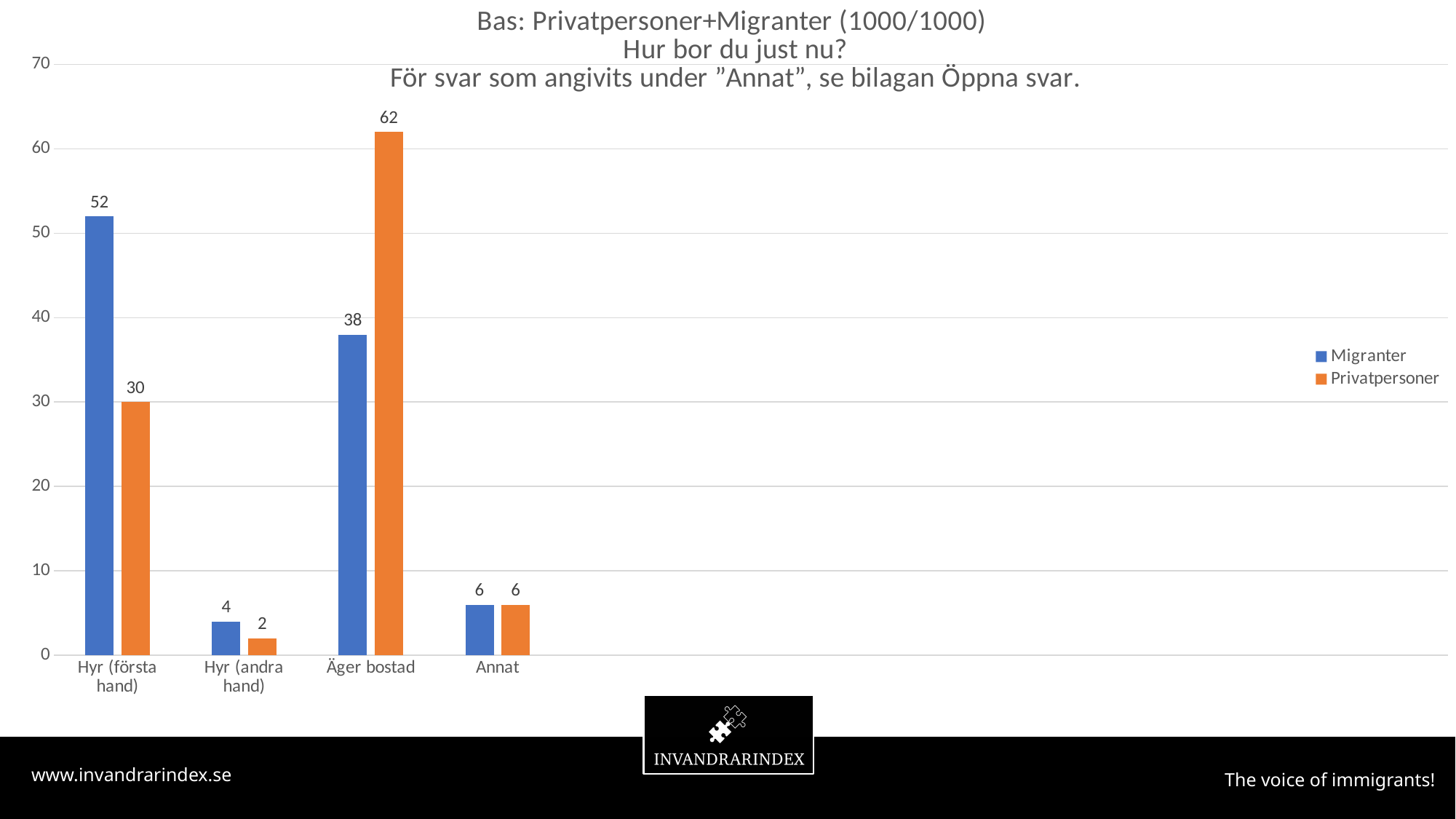
What is the value for Privatpersoner in the Hyr (andra hand) category? 2 Which category has the lowest value for the Privatpersoner series? Hyr (andra hand) Is the value for Migranter in the Äger bostad category greater or less than 40? less Which category has the highest value for the Migranter series? Hyr (första hand) What is the value for Migranter in the Hyr (första hand) category? 52 What kind of chart is shown on the slide? bar chart How many series does the legend list? 2 Which is larger in the Hyr (första hand) category, Migranter or Privatpersoner? Migranter What is the difference between Privatpersoner and Migranter in the Äger bostad category? 24 What is the value for Privatpersoner in the Äger bostad category? 62 How many categories are shown on the x axis? 4 Which colour represents the Privatpersoner series? orange